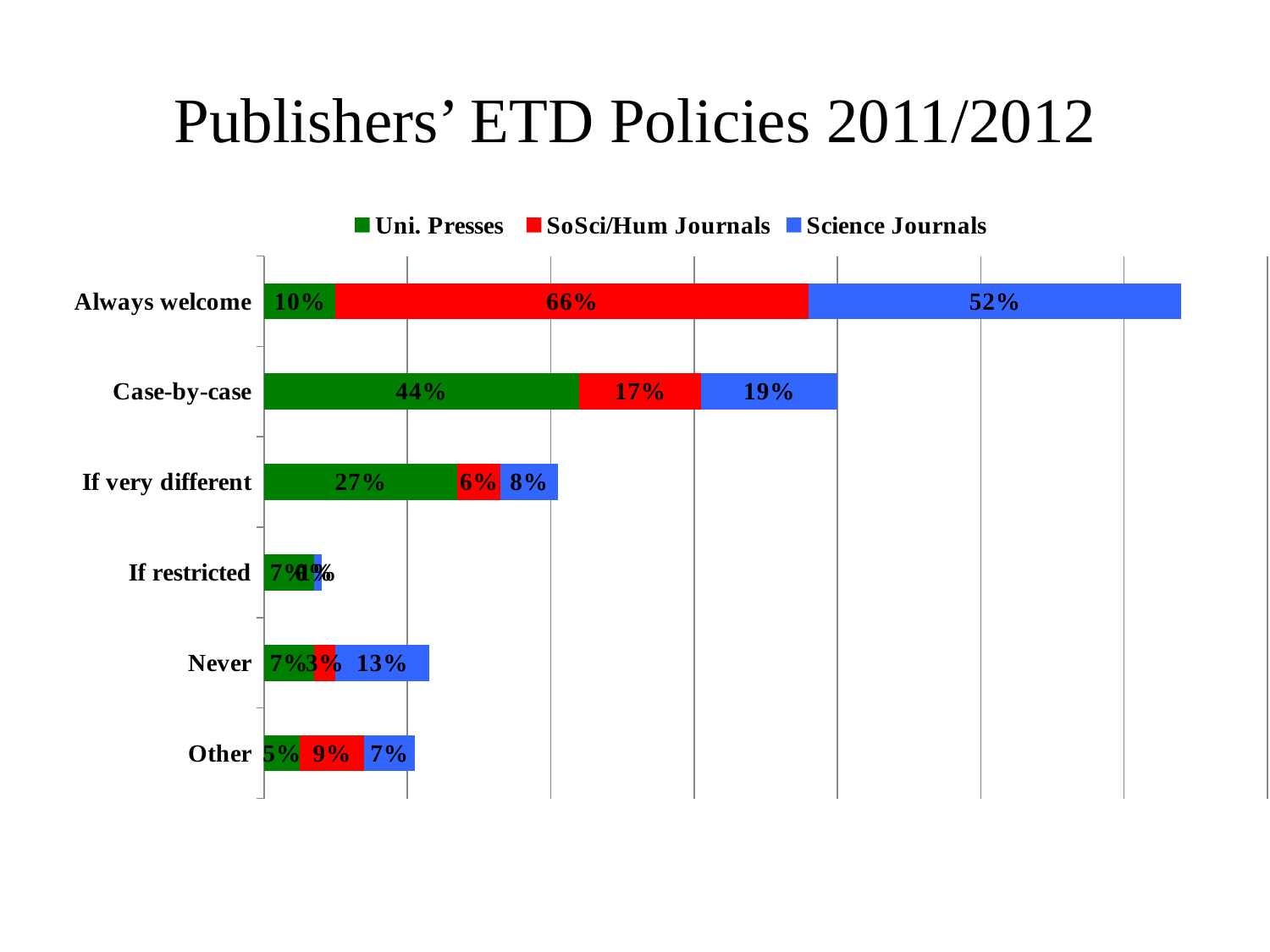
Which is larger in the Other category: the SoSci/Hum Journals value or the Science Journals value? SoSci/Hum Journals What is the value for Uni. Presses in the Case-by-case category? 44% How many policy categories are shown on the chart? 6 Which category has the highest value for Uni. Presses? Case-by-case What is the value for Science Journals in the If very different category? 8% Which category has the highest value for Science Journals? Always welcome What kind of chart is shown on the slide? Stacked bar chart What is the total of the stacked bar for the Case-by-case category? 80% What is the difference between the Science Journals and Uni. Presses values in the Always welcome category? 42% What is the value for SoSci/Hum Journals in the Always welcome category? 66% How many series does the legend list? 3 What is the value for Science Journals in the Never category? 13%